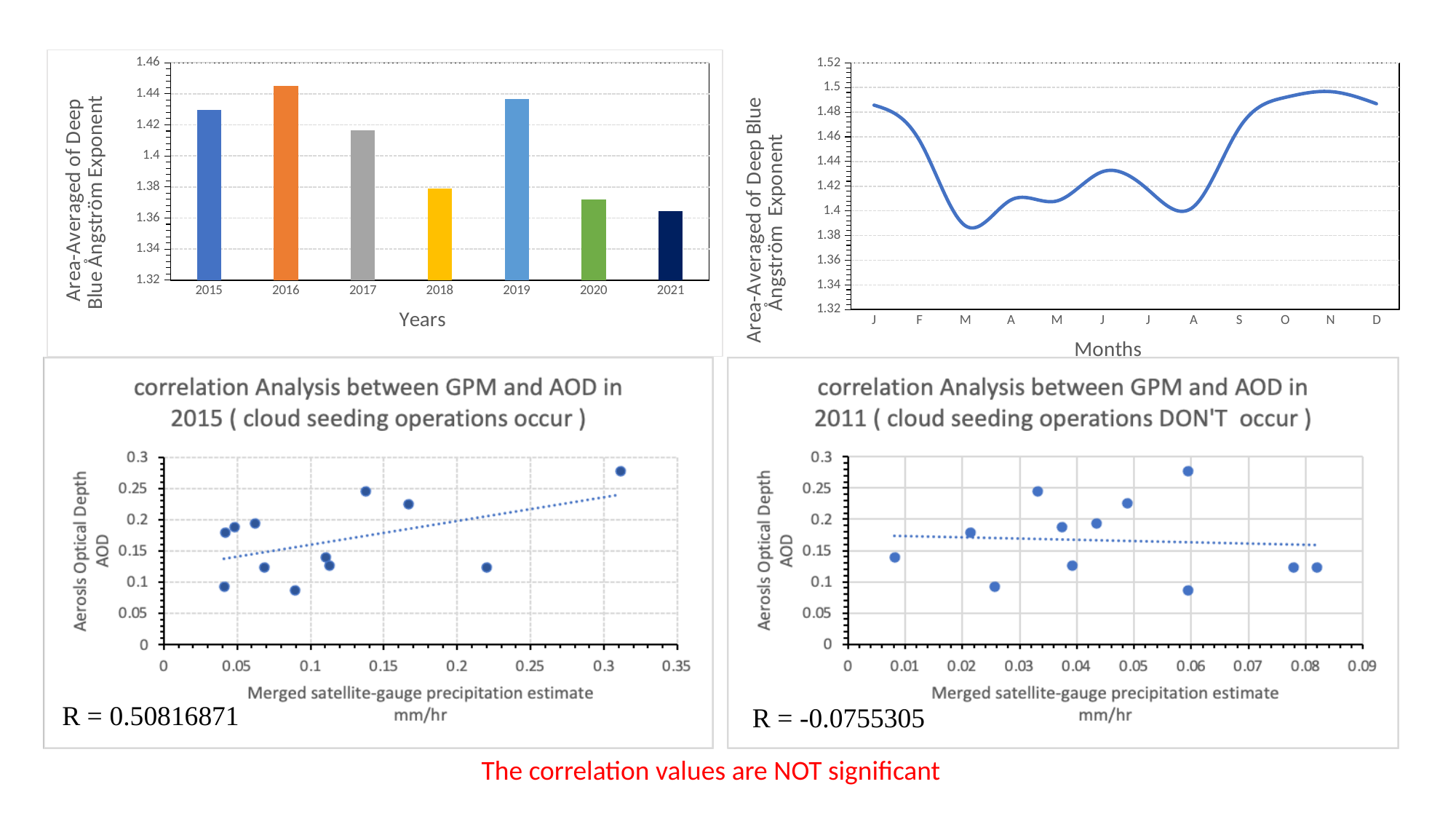
In the top-left bar chart, how many years are shown on the x axis? 7 In the top-left bar chart, is the value for 2020 greater or less than 1.38? less In the top-left bar chart, which year has the highest Area-Averaged Deep Blue Ångström Exponent? 2016 What is the R value shown for the chart titled 'correlation Analysis between GPM and AOD in 2011 (cloud seeding operations DON'T occur)'? R = -0.0755305 What kind of chart is the top-right chart with months on the x axis? line chart In the top-right line chart, is the value for March (M) greater or less than 1.4? less What kind of chart is the top-left chart with years on the x axis? bar chart In the top-right line chart, how many months are shown on the x axis? 12 What is the R value shown for the chart titled 'correlation Analysis between GPM and AOD in 2015 (cloud seeding operations occur)'? R = 0.50816871 In the top-left bar chart, which is larger, the value for 2019 or the value for 2018? 2019 In the top-left bar chart, is the value for 2017 greater or less than 1.4? greater